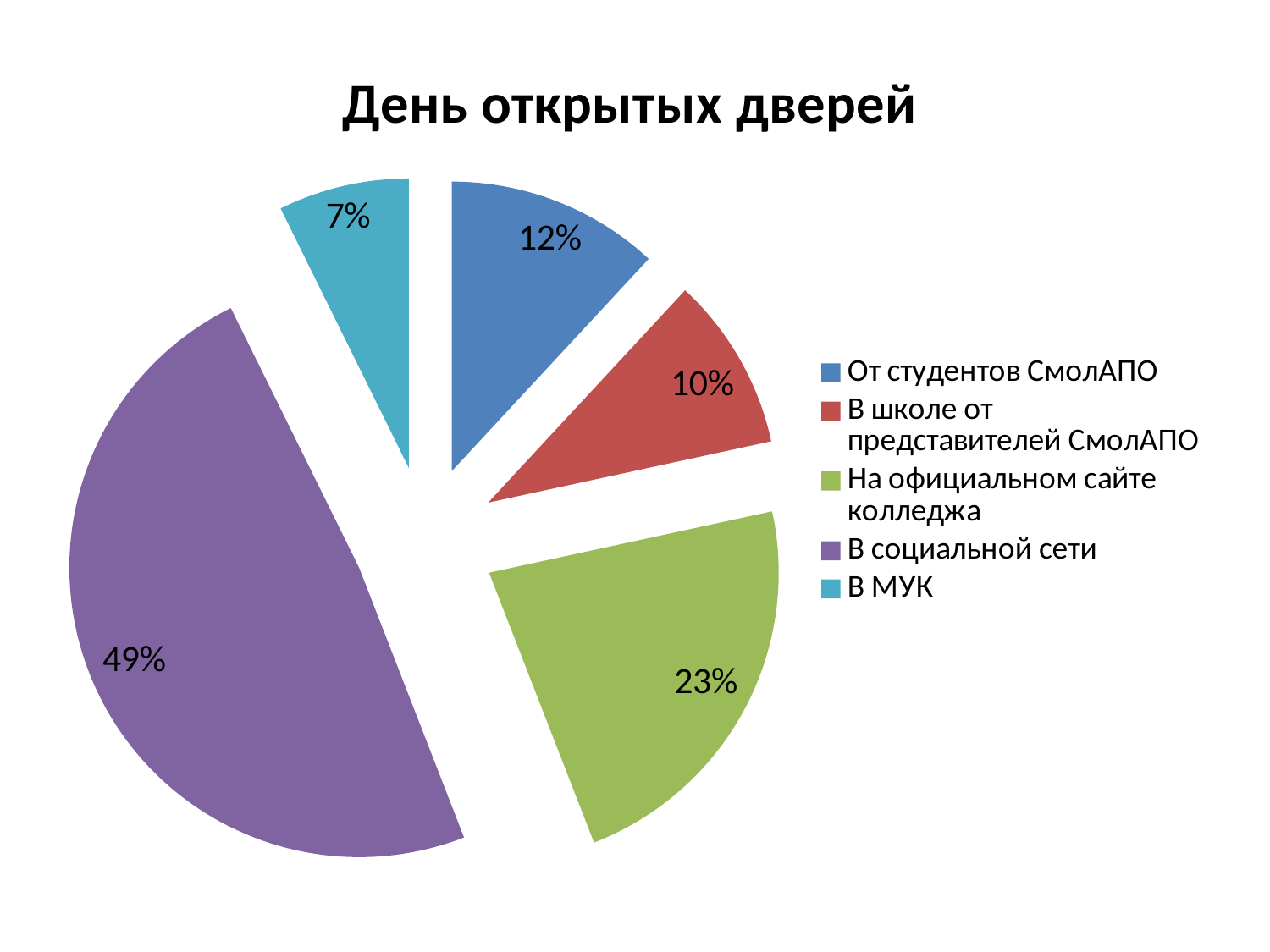
How many categories does the pie chart have? 5 What is the value for "В МУК"? 7% What share of the pie does "В социальной сети" have? 49% Which category has the smallest share of the pie? В МУК What is the value for "В школе от представителей СмолАПО"? 10% What kind of chart is shown on the slide? Pie chart What is the value for "От студентов СмолАПО"? 12% Which is larger: the share for "От студентов СмолАПО" or for "В школе от представителей СмолАПО"? От студентов СмолАПО Which category has the largest share of the pie? В социальной сети What is the difference between the shares for "В социальной сети" and "На официальном сайте колледжа"? 26% What is the title of the chart? День открытых дверей What share of the pie does "На официальном сайте колледжа" have? 23%